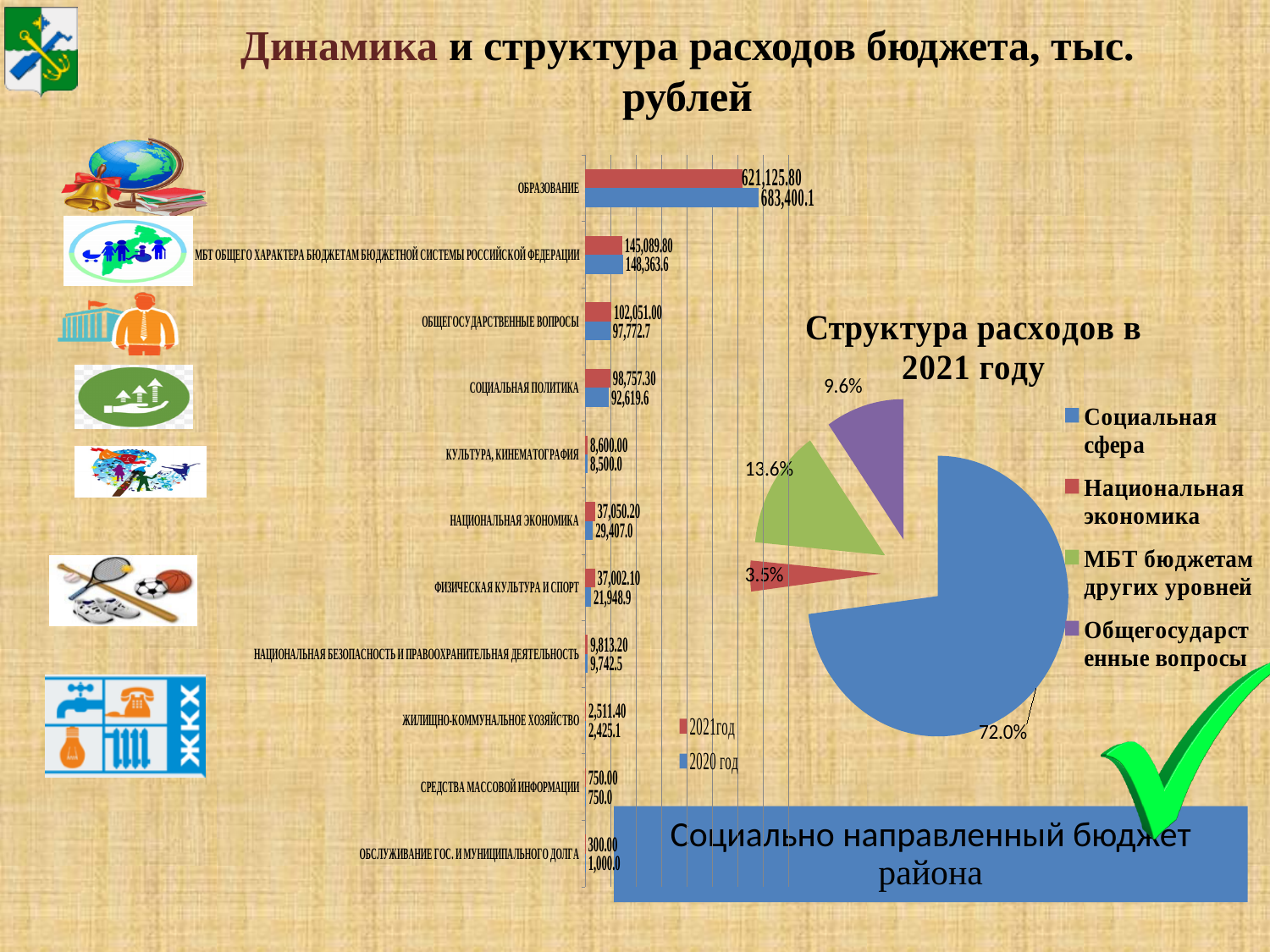
On the bar chart on the left, which category has the highest value in 2020 год? Образование In the pie chart 'Структура расходов в 2021 году', which category has the smallest share? Национальная экономика How many series does the legend of the bar chart on the left list? 2 How many categories does the bar chart on the left show? 11 What kind of chart is the chart on the left of the slide? Bar chart In the pie chart 'Структура расходов в 2021 году', what share does Социальная сфера have? 72.0% On the bar chart on the left, what is the value for Физическая культура и спорт in 2021год? 37,002.10 On the bar chart on the left, what is the value for Образование in 2021год? 621,125.80 On the bar chart on the left, what is the difference between the 2020 год and 2021год values for Образование? 62,274.3 On the bar chart on the left, which is larger for Общегосударственные вопросы: the 2021год value or the 2020 год value? 2021год On the bar chart on the left, which category has the lowest value in 2021год? Обслуживание гос. и муниципального долга On the bar chart on the left, what is the value for Национальная экономика in 2020 год? 29,407.0